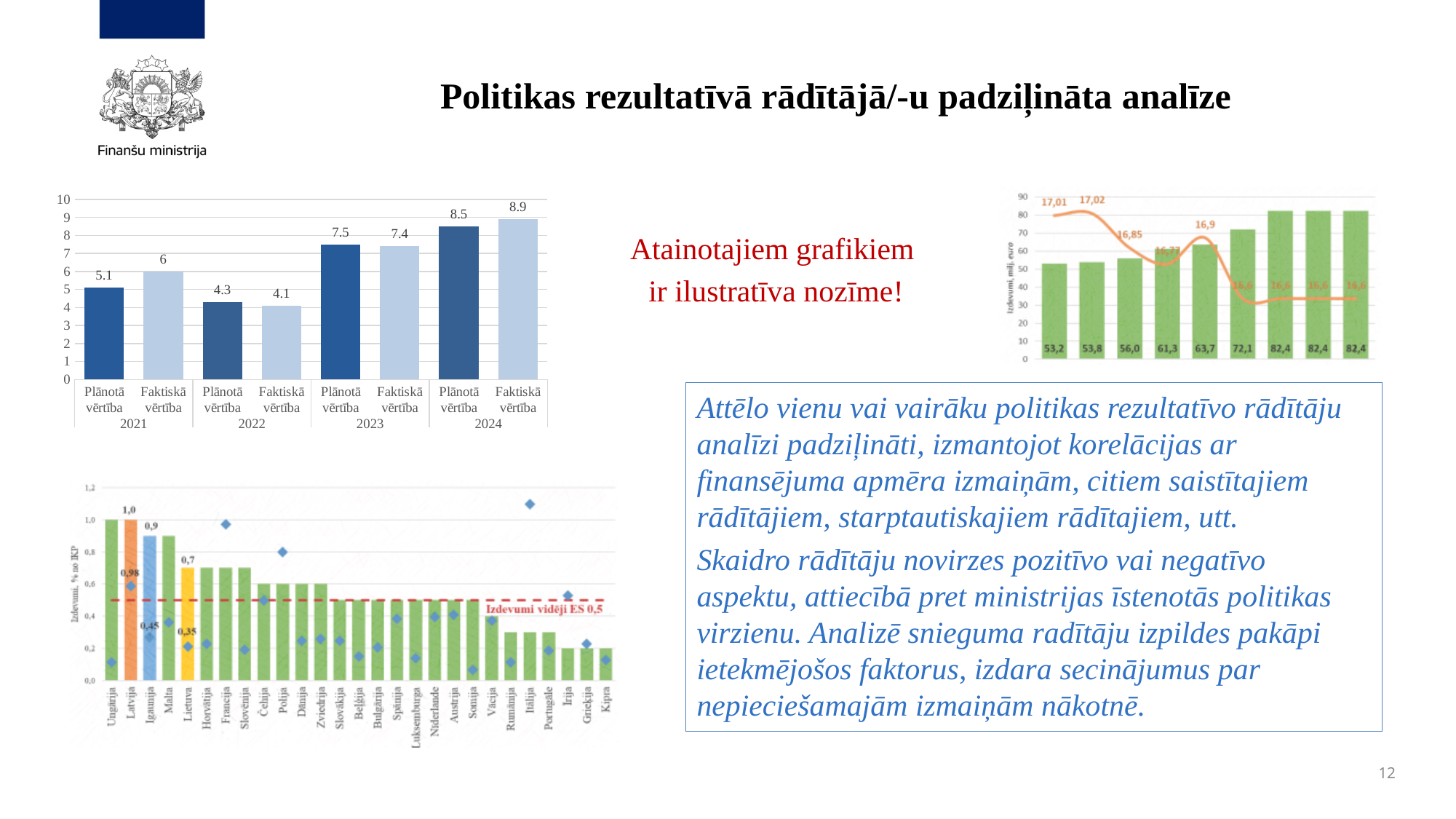
In the top-left bar chart, what is the Plānotā vērtība for 2021? 5.1 In the bottom-left chart, what is the value labelled on the bar for Lietuva? 0,7 What kind of chart is the top-left chart? Bar chart In the top-right chart, what is the highest bar value shown? 82,4 In the top-left bar chart, what is the Faktiskā vērtība for 2024? 8.9 How many green bars are in the top-right chart? 9 In the top-left bar chart, what is the difference between the Faktiskā vērtība and the Plānotā vērtība for 2021? 0.9 In the top-right chart, what is the value of the first green bar? 53,2 In the bottom-left chart, what value does the dashed line labelled 'Izdevumi vidēji ES' represent? 0,5 In the top-left bar chart, which bar has the lowest value? Faktiskā vērtība 2022 (4.1) In the top-left bar chart, which is larger for 2023: the Plānotā vērtība or the Faktiskā vērtība? Plānotā vērtība (7.5) How many bars are plotted in the top-left bar chart? 8